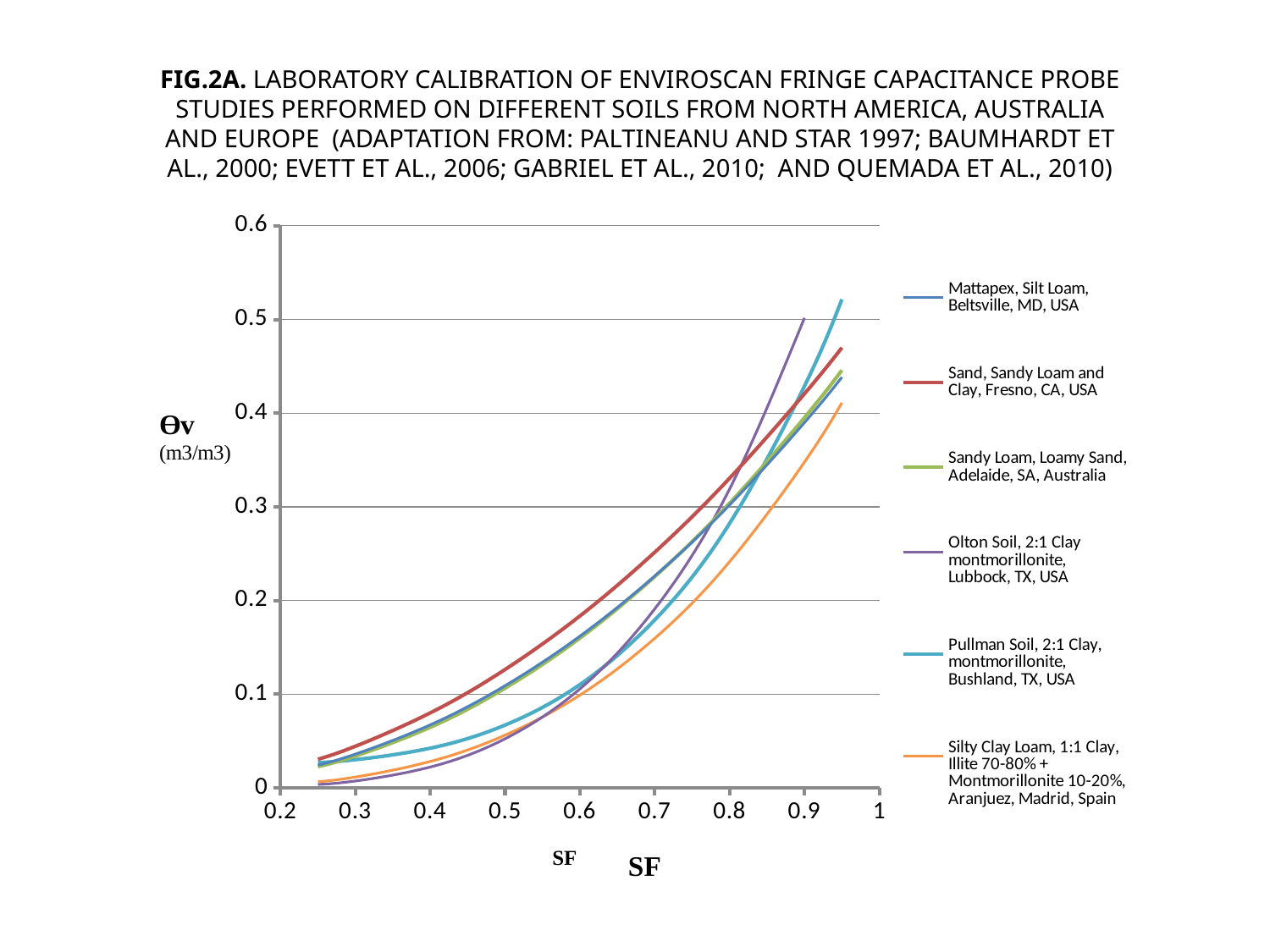
Is the value for the Pullman Soil, Bushland, TX, USA series at SF 0.95 greater or less than 0.5? greater Is the value for the Sand, Sandy Loam and Clay, Fresno, CA, USA series at SF 0.5 greater or less than 0.2? less What kind of chart is shown on the slide? Line chart Which series reaches the highest value at the right end of the chart (SF 0.95)? Pullman Soil, 2:1 Clay, montmorillonite, Bushland, TX, USA At SF 0.95, which is larger: the value for Pullman Soil, Bushland, TX, USA or the value for Silty Clay Loam, Aranjuez, Madrid, Spain? Pullman Soil, Bushland, TX, USA At SF 0.5, which is larger: the value for Sand, Sandy Loam and Clay, Fresno, CA, USA or the value for Silty Clay Loam, Aranjuez, Madrid, Spain? Sand, Sandy Loam and Clay, Fresno, CA, USA What colour is the line for the Silty Clay Loam, Aranjuez, Madrid, Spain series? Orange Do the values for the Pullman Soil series rise or fall as SF increases? Rise What is the label on the x axis of the chart? SF Do the values for the Silty Clay Loam, Aranjuez, Madrid, Spain series rise or fall along the x axis? Rise How many series does the legend list? 6 Is the value for the Mattapex, Silt Loam, Beltsville, MD, USA series at SF 0.95 greater or less than 0.5? less